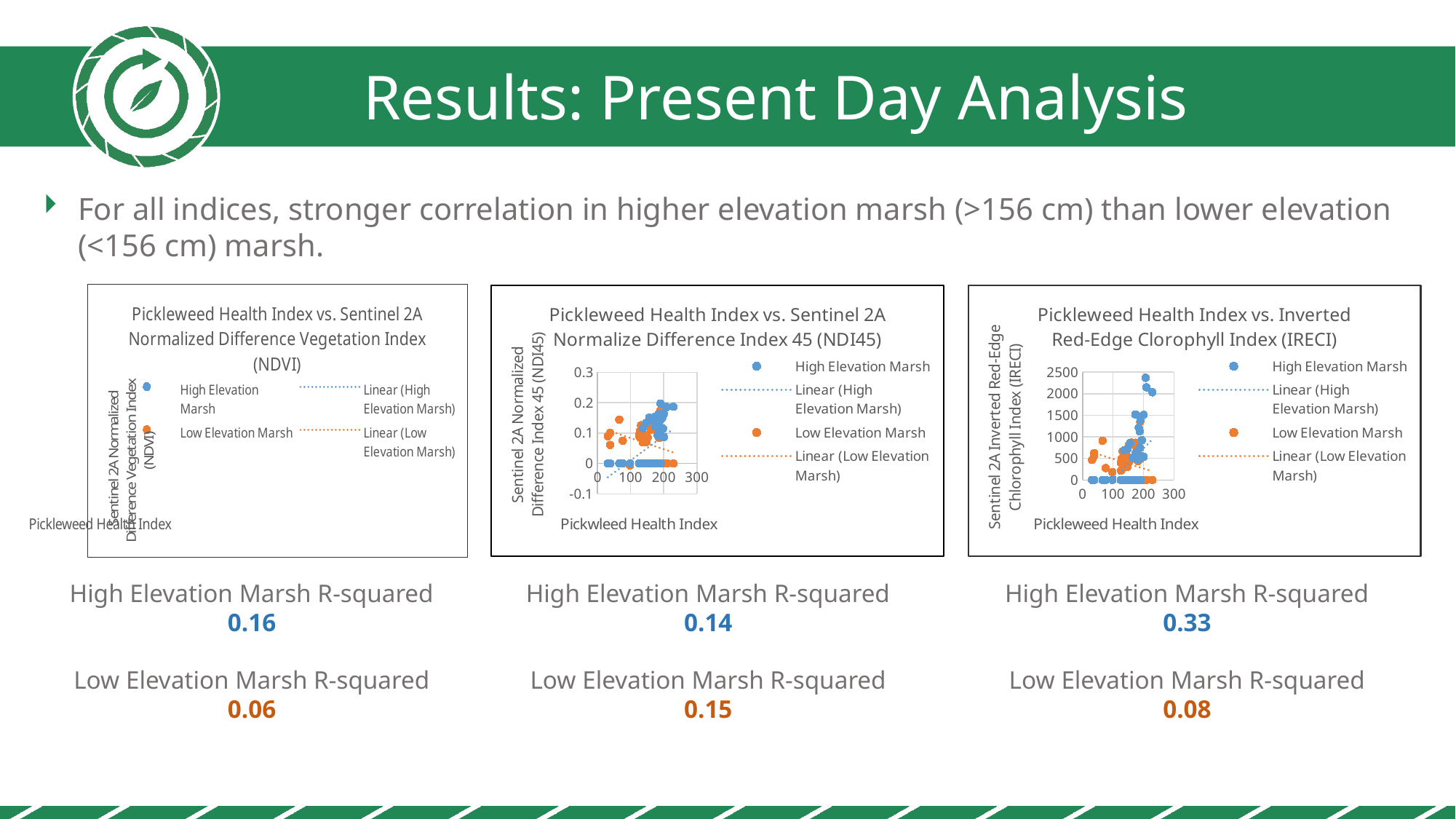
What kind of chart is the right chart, 'Pickleweed Health Index vs. Inverted Red-Edge Clorophyll Index (IRECI)'? Scatter chart In the right chart (IRECI), which colour represents the High Elevation Marsh points? Blue In the middle chart (NDI45), is the highest plotted point greater or less than 0.3 on the y axis? less In the right chart (IRECI), is the highest Low Elevation Marsh point greater or less than 1500 on the y axis? less What is the maximum value shown on the y axis of the right chart (IRECI)? 2500 How many entries does the legend of the right chart (IRECI) list? 4 What kind of chart is the middle chart, 'Pickleweed Health Index vs. Sentinel 2A Normalize Difference Index 45 (NDI45)'? Scatter chart What is the High Elevation Marsh R-squared value reported for the right chart (IRECI)? 0.33 In the middle chart (NDI45), which colour represents the Low Elevation Marsh points? Orange How many entries does the legend of the middle chart (NDI45) list? 4 What is the Low Elevation Marsh R-squared value reported for the middle chart (NDI45)? 0.15 In the right chart (IRECI), is the highest High Elevation Marsh point greater or less than 2000 on the y axis? greater